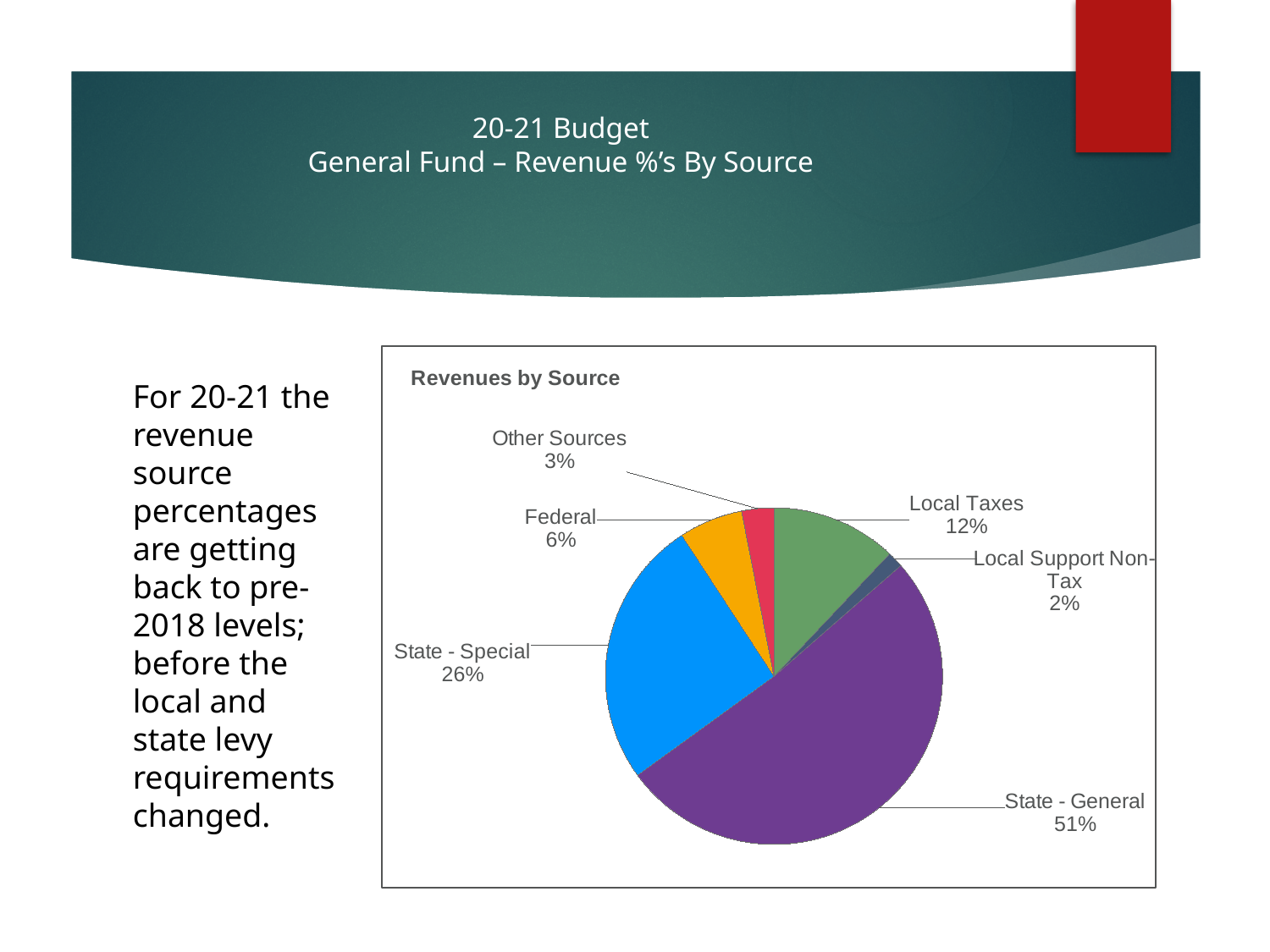
Which revenue source has the smallest share of the pie? Local Support Non-Tax What is the combined share of State - General and State - Special? 77% Which is larger, the share for Federal or the share for Other Sources? Federal What percentage of revenue comes from Federal sources? 6% How many revenue source categories are shown in the pie chart? 6 Which revenue source has the largest share of the pie? State - General What is the title of the chart? Revenues by Source What type of chart is shown on the slide? Pie chart What percentage of revenue comes from Local Support Non-Tax? 2% What percentage of revenue comes from State - General? 51% What is the difference in percentage points between State - General and State - Special? 25 What percentage of revenue comes from Local Taxes? 12%